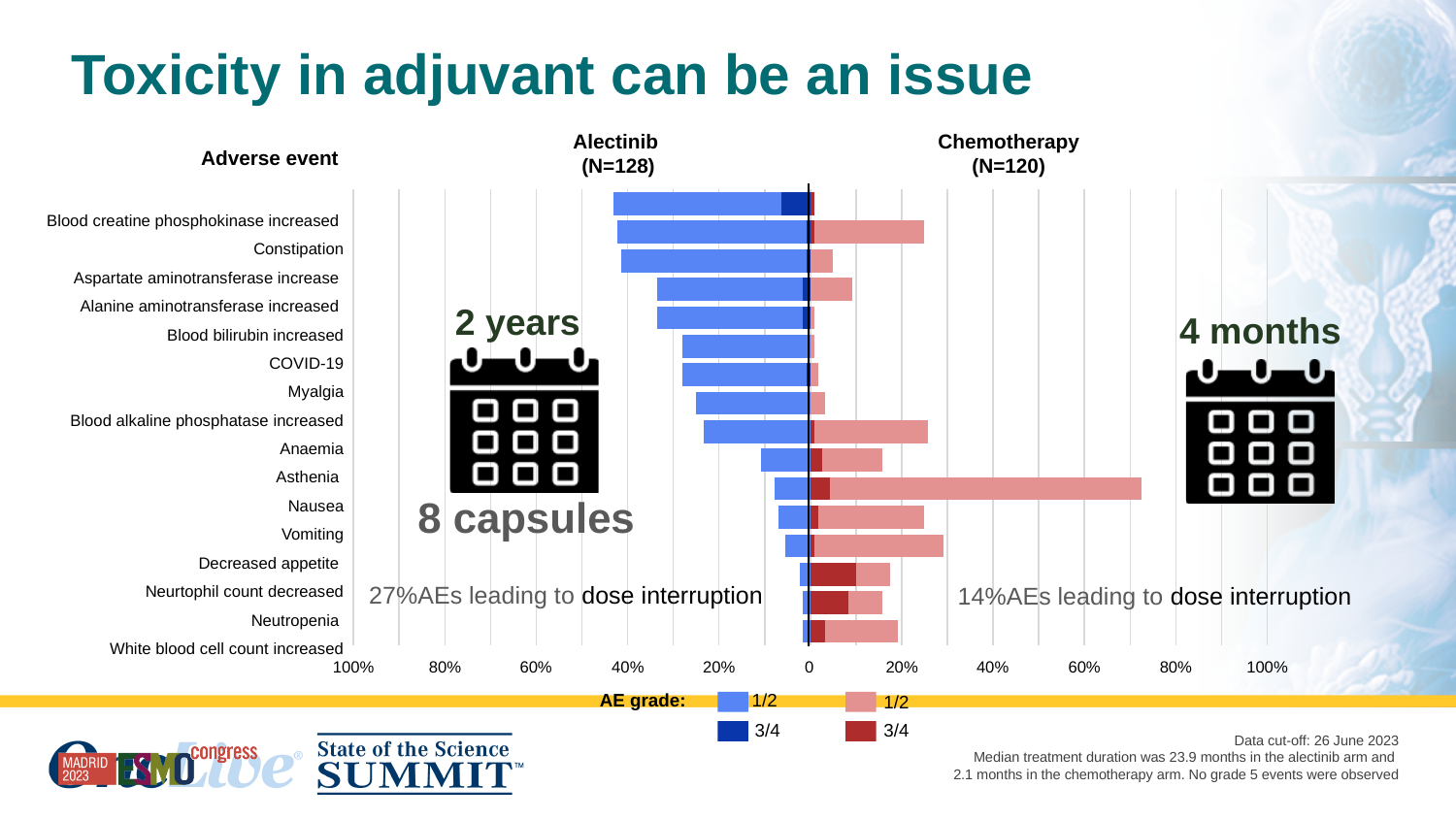
How many adverse events are listed on the chart? 16 Is the Chemotherapy value for Constipation greater or less than 40%? less Which adverse event has the longest bar in the Chemotherapy arm? Nausea For Blood creatine phosphokinase increased, which arm has the larger value, Alectinib or Chemotherapy? Alectinib What is the N shown for the Chemotherapy arm? N=120 Is the Chemotherapy value for Nausea greater or less than 60%? greater For Nausea, which arm has the larger value, Alectinib or Chemotherapy? Chemotherapy Is the Alectinib value for Blood creatine phosphokinase increased greater or less than 20%? greater How many entries does the AE grade legend list? 4 For Constipation, which arm has the larger value, Alectinib or Chemotherapy? Alectinib What kind of chart is shown on the slide? bar chart What is the N shown for the Alectinib arm? N=128